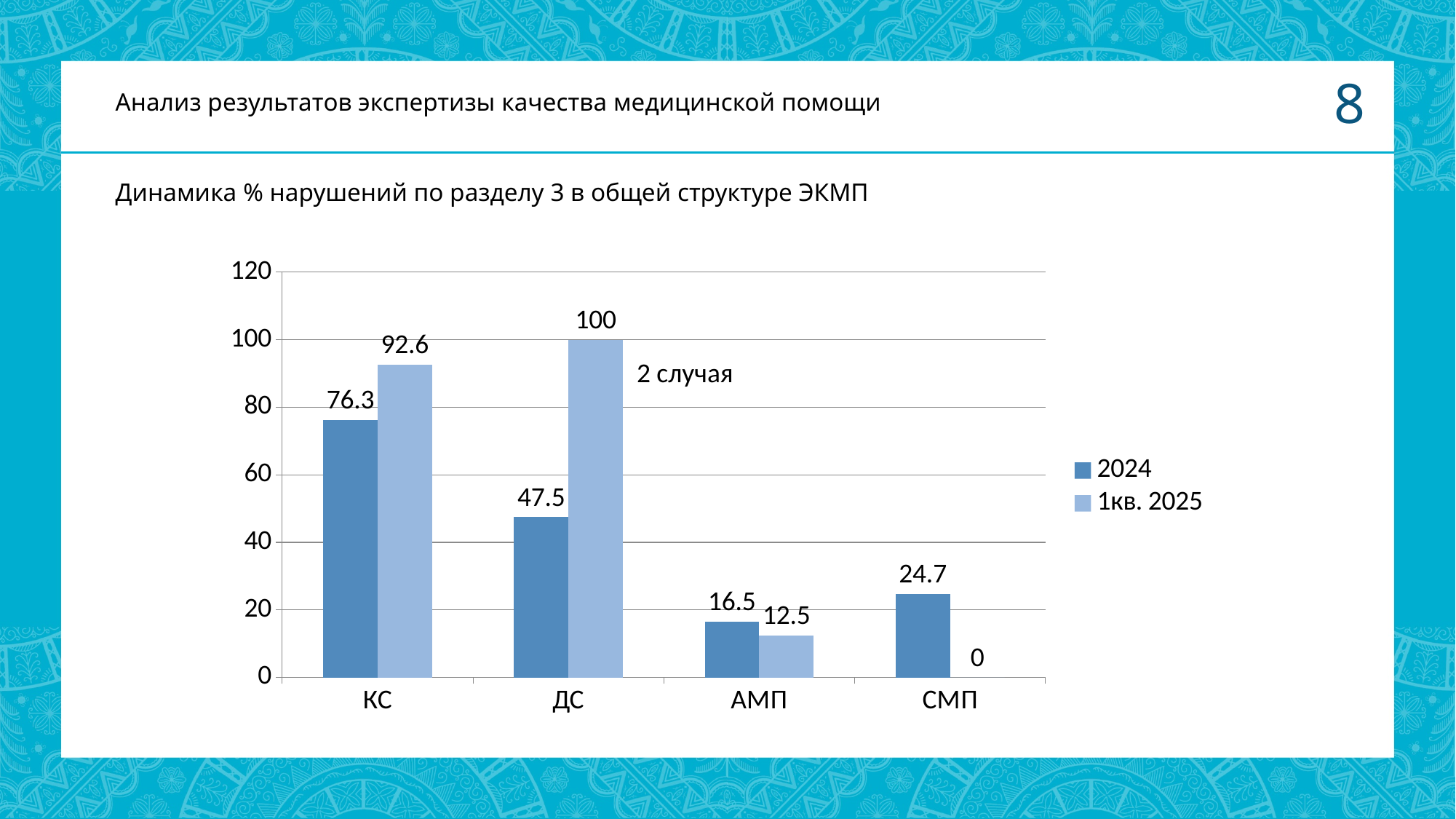
What kind of chart is shown on the slide? Bar chart Which category has the highest value in the 2024 series? КС How many categories are shown on the x axis? 4 What is the value for КС in the 2024 series? 76.3 Which category has the lowest value in the 1кв. 2025 series? СМП What is the difference between the 1кв. 2025 and 2024 values for ДС? 52.5 What is the value for ДС in the 1кв. 2025 series? 100 What is the value for СМП in the 1кв. 2025 series? 0 How many series does the legend list? 2 Which is larger for АМП: the 2024 value or the 1кв. 2025 value? 2024 What annotation text is placed next to the ДС bar for 1кв. 2025? 2 случая What is the value for АМП in the 2024 series? 16.5